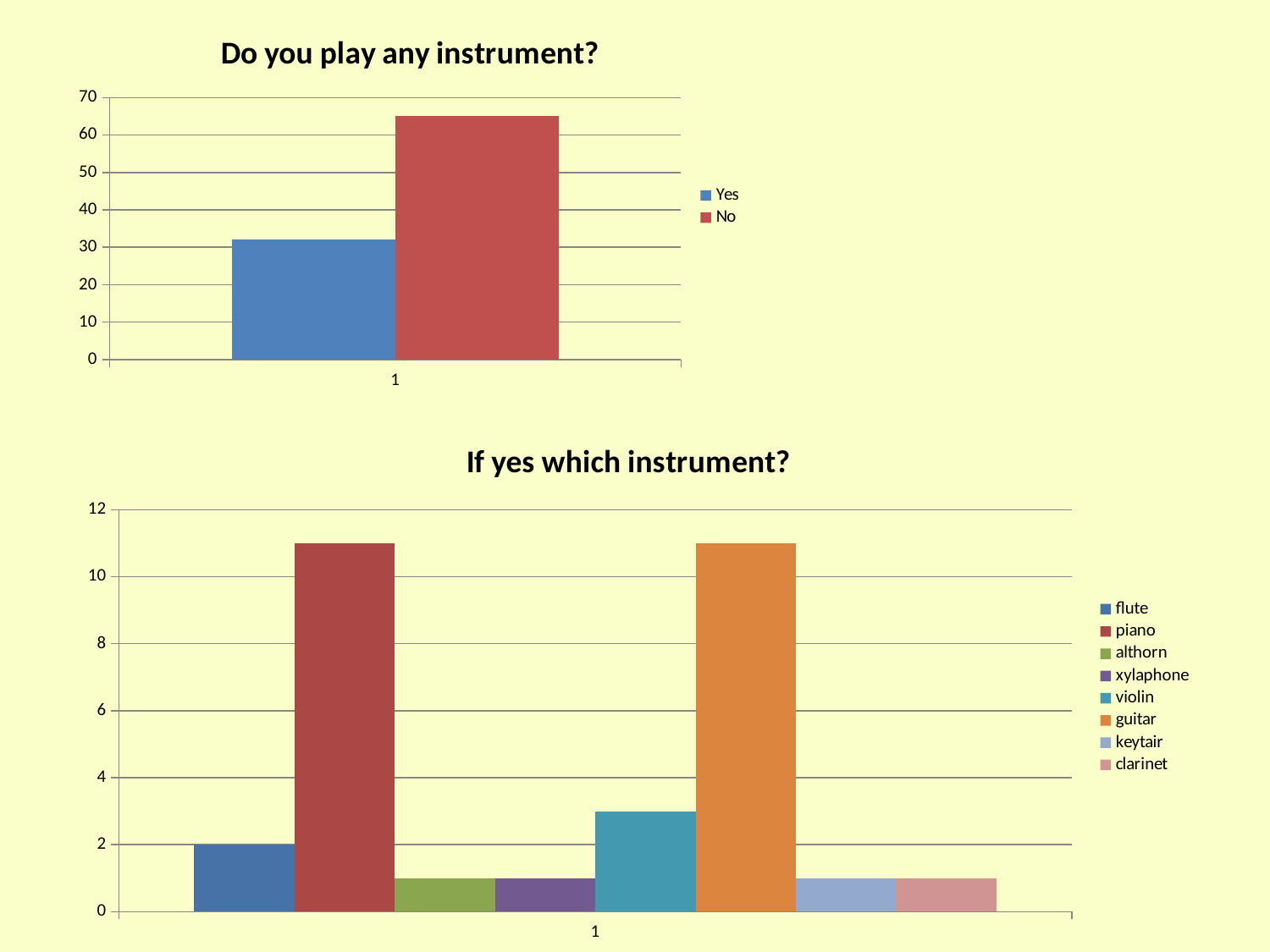
In the chart titled "Do you play any instrument?", is the value for Yes greater or less than 40? less What kind of chart is the chart titled "Do you play any instrument?"? bar chart In the chart titled "If yes which instrument?", is the value for violin greater or less than 4? less In the chart titled "If yes which instrument?", which is larger, violin or althorn? violin In the chart titled "Do you play any instrument?", how many series does the legend list? 2 In the chart titled "Do you play any instrument?", is the value for No greater or less than 60? greater In the chart titled "Do you play any instrument?", which is larger, Yes or No? No In the chart titled "If yes which instrument?", what colour is the guitar bar? orange In the chart titled "If yes which instrument?", how many series does the legend list? 8 In the chart titled "If yes which instrument?", what is the value for flute? 2